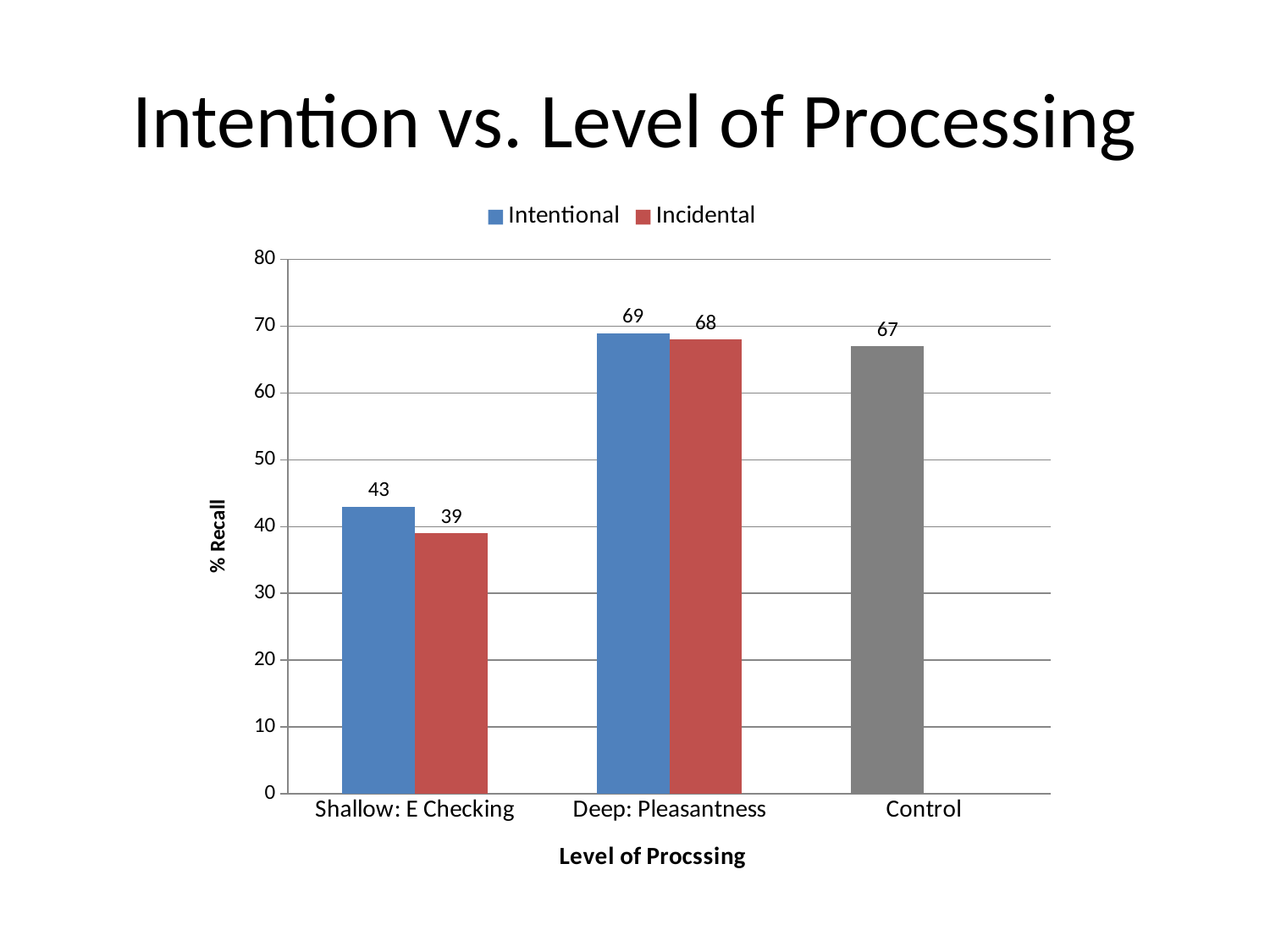
What is the label of the y axis? % Recall Which category has the lowest Incidental value? Shallow: E Checking How many categories are shown on the x axis? 3 How many series does the legend list? 2 What kind of chart is shown on the slide? Bar chart What is the Incidental value for Shallow: E Checking? 39 What is the value shown for the Control bar? 67 Which category has the highest Intentional value? Deep: Pleasantness What is the Incidental value for Deep: Pleasantness? 68 What is the difference between the Intentional and Incidental values for Shallow: E Checking? 4 Which is larger for Deep: Pleasantness, the Intentional value or the Incidental value? Intentional What is the Intentional value for Shallow: E Checking? 43